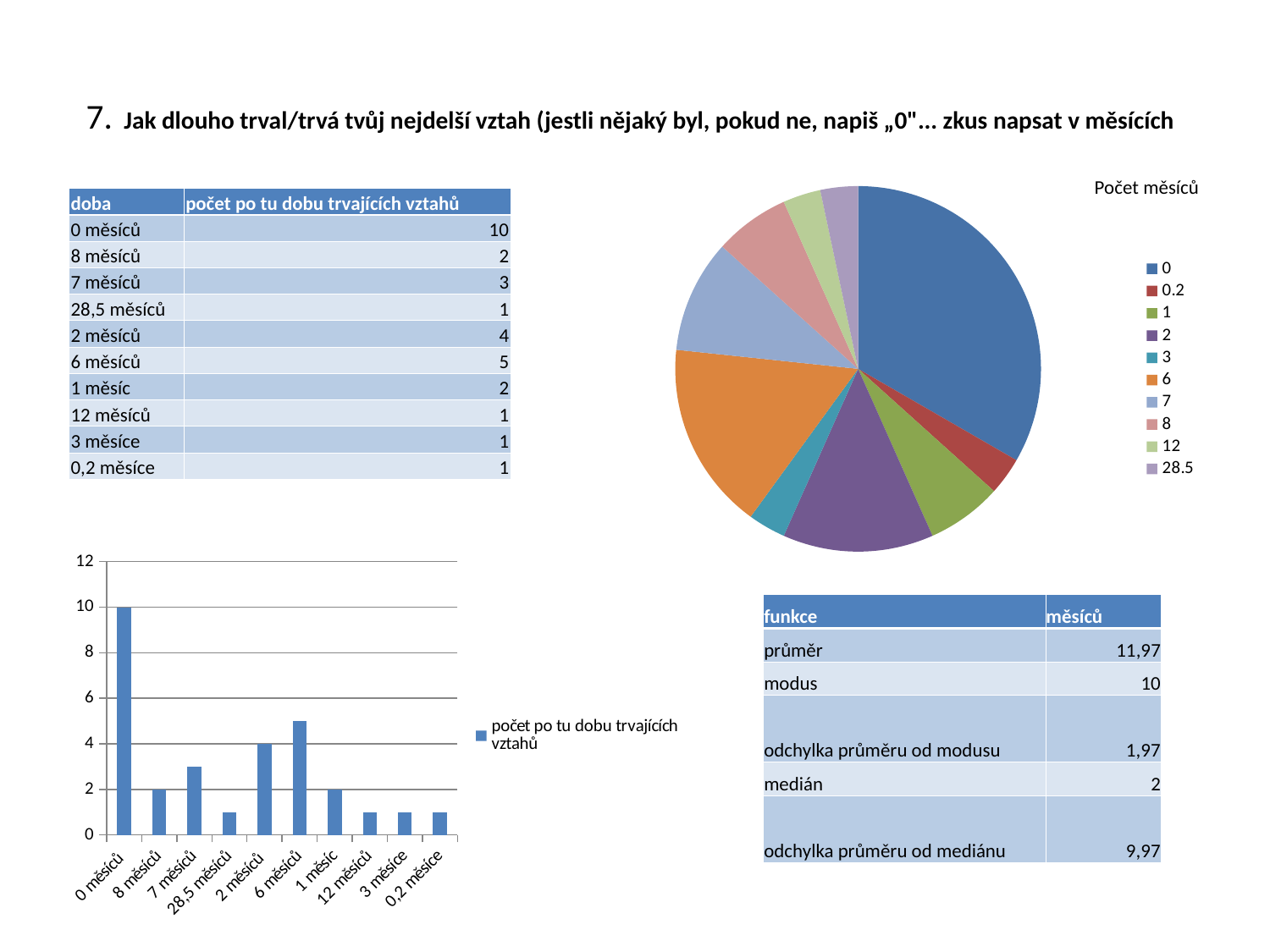
In the bar chart at the bottom left, what is the difference between the value for "0 měsíců" and the value for "2 měsíců"? 6 In the bar chart at the bottom left, how many series does the legend list? 1 In the bar chart at the bottom left, which category has the highest value? 0 měsíců In the bar chart at the bottom left, is the value for "6 měsíců" greater or less than 4? greater In the pie chart titled "Počet měsíců", how many entries does the legend list? 10 In the pie chart titled "Počet měsíců", which legend entry corresponds to the largest slice? 0 In the bar chart at the bottom left, how many categories are shown on the x axis? 10 In the bar chart at the bottom left, what is the value for "0 měsíců"? 10 What kind of chart is the chart titled "Počet měsíců"? pie chart In the bar chart at the bottom left, which is larger, the value for "6 měsíců" or the value for "7 měsíců"? 6 měsíců In the bar chart at the bottom left, what is the value for "2 měsíců"? 4 What kind of chart is the chart at the bottom left of the slide? bar chart